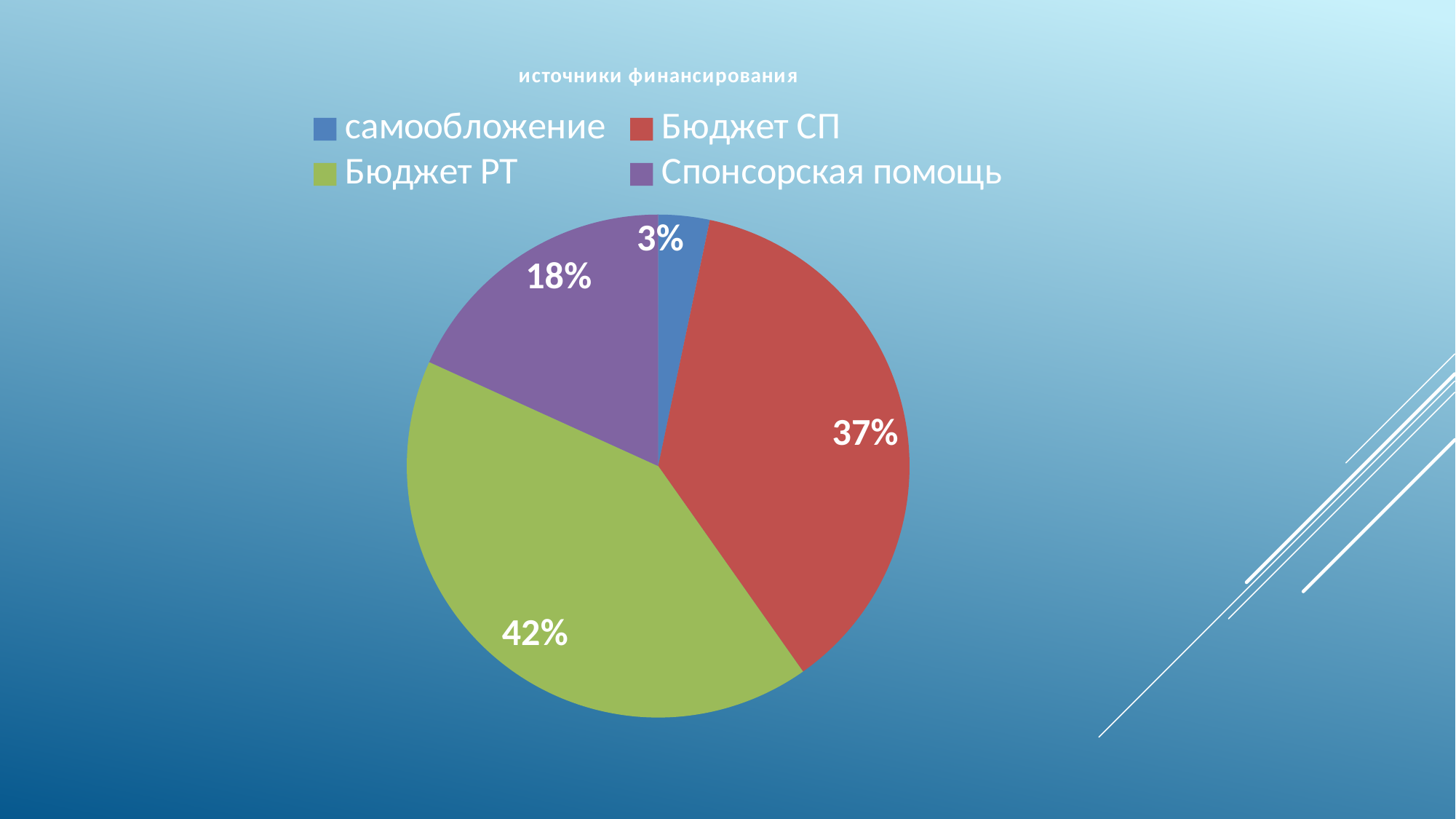
What is the difference in percentage points between the shares of Бюджет РТ and Бюджет СП? 5% Which category has the smallest share of the pie? самообложение Which is larger, the share for Бюджет СП or the share for Спонсорская помощь? Бюджет СП What share of the pie is Спонсорская помощь? 18% How many categories does the legend list? 4 What is the title of the chart? источники финансирования What share of the pie is Бюджет РТ? 42% What share of the pie is самообложение? 3% What type of chart is shown on the slide? pie chart What colour is the slice for Спонсорская помощь? purple Which category has the largest share of the pie? Бюджет РТ